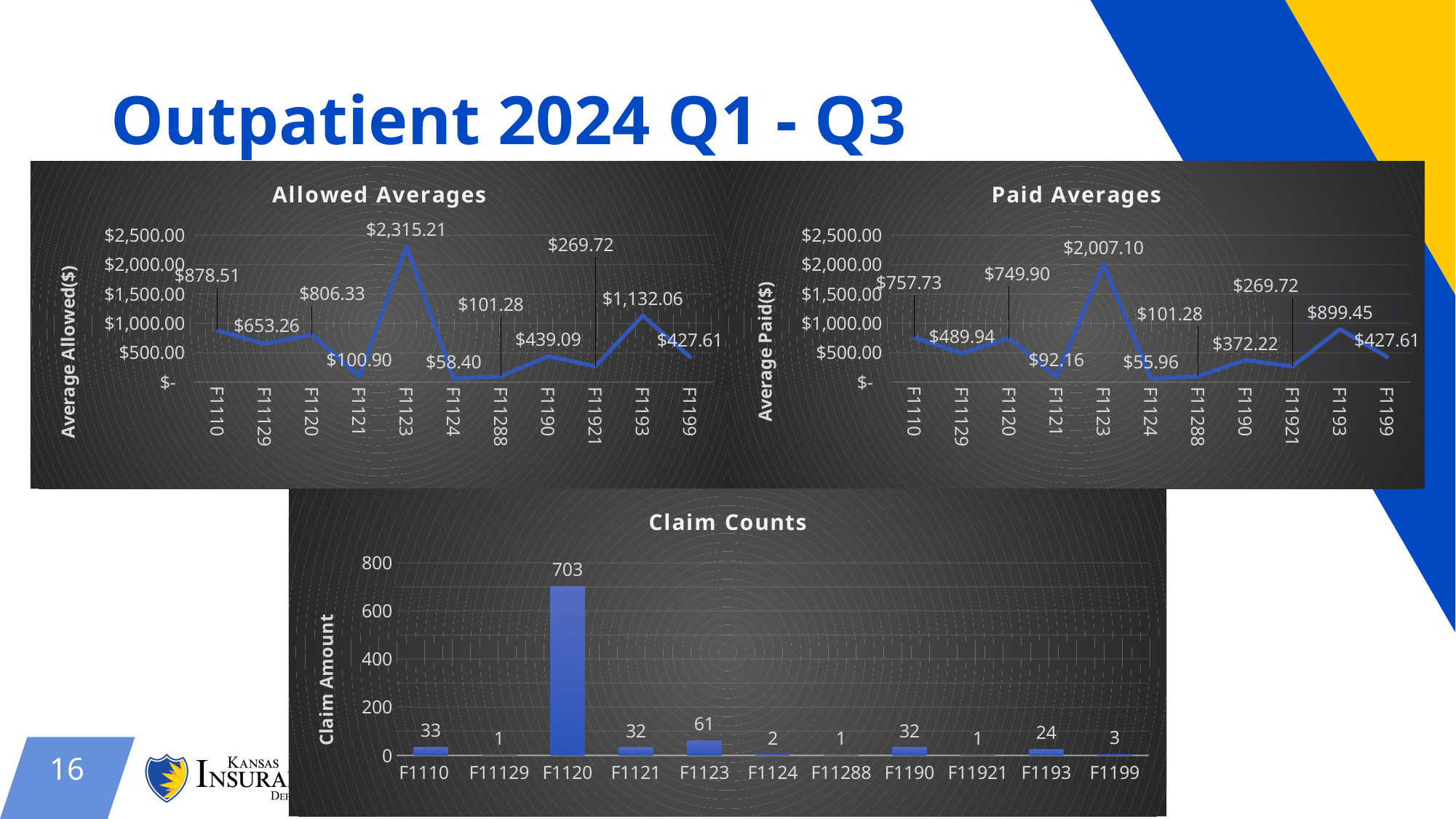
In the Claim Counts chart, which category has the highest claim count? F1120 In the Allowed Averages chart, which category has the lowest average allowed amount? F1124 In the Paid Averages chart, what is the average paid amount for F1193? $899.45 In the Claim Counts chart, which has the larger claim count, F1110 or F1193? F1110 In the Paid Averages chart, is the value for F1123 greater or less than $1,500.00? greater In the Allowed Averages chart, which category has the highest average allowed amount? F1123 What kind of chart is the Paid Averages chart? line chart In the Allowed Averages chart, what is the average allowed amount for F1123? $2,315.21 In the Paid Averages chart, which category has the lowest average paid amount? F1124 In the Allowed Averages chart, what is the difference between the values for F1123 and F1193? $1,183.15 In the Claim Counts chart, what is the claim count for F1123? 61 How many categories are shown in the Claim Counts chart? 11